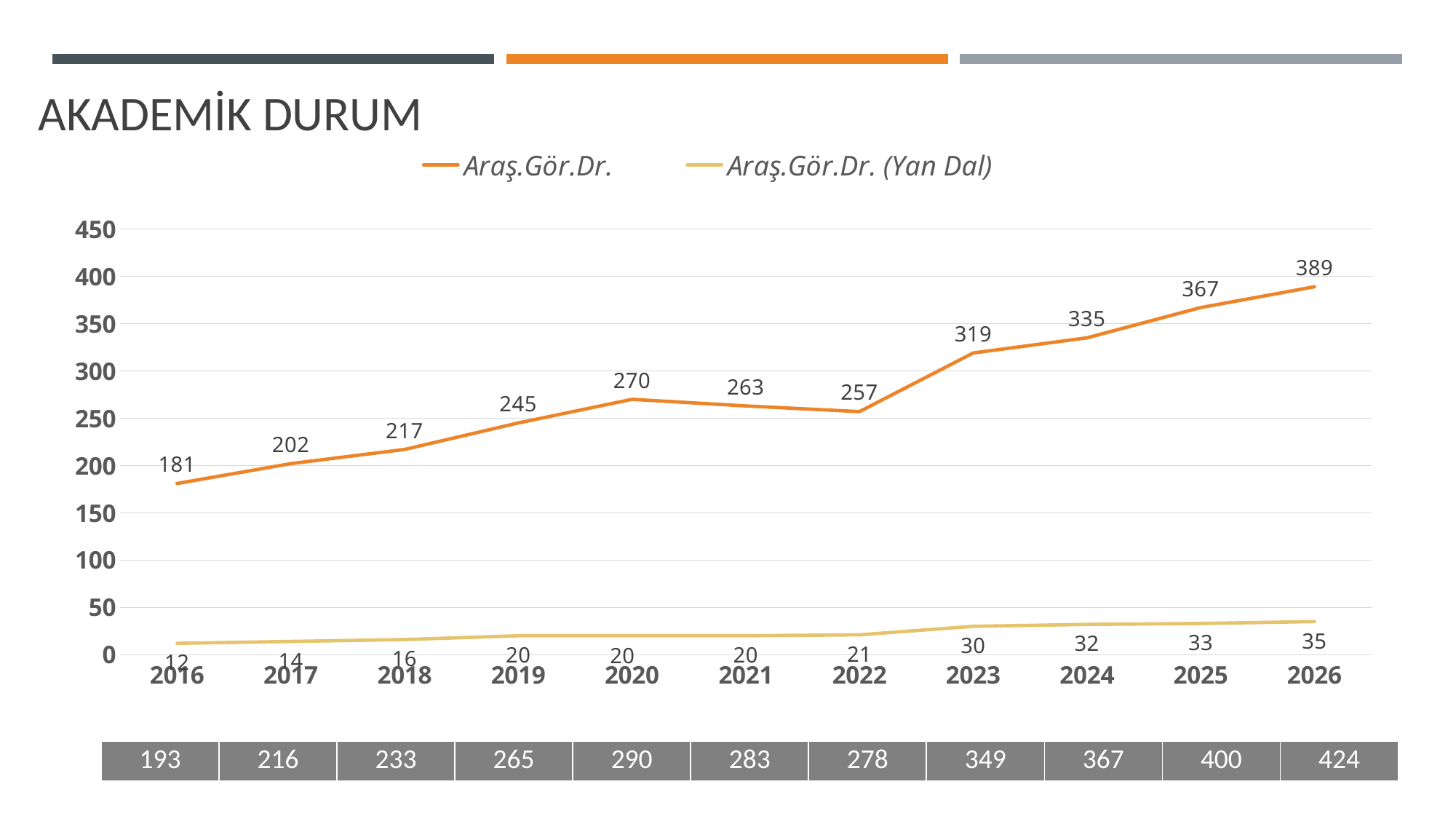
What is the difference between the Araş.Gör.Dr. values for 2026 and 2025? 22 In which year is the Araş.Gör.Dr. (Yan Dal) series lowest? 2016 What is the value for Araş.Gör.Dr. in 2016? 181 Which is larger for Araş.Gör.Dr.: the value in 2021 or the value in 2022? 2021 In which year is the Araş.Gör.Dr. series highest? 2026 How many years are shown on the x axis? 11 Is the value for Araş.Gör.Dr. in 2023 greater or less than 300? greater How many series does the legend list? 2 What is the value for Araş.Gör.Dr. in 2020? 270 What is the value for Araş.Gör.Dr. (Yan Dal) in 2023? 30 Does the Araş.Gör.Dr. series rise or fall between 2020 and 2022? fall What kind of chart is shown on the slide? line chart